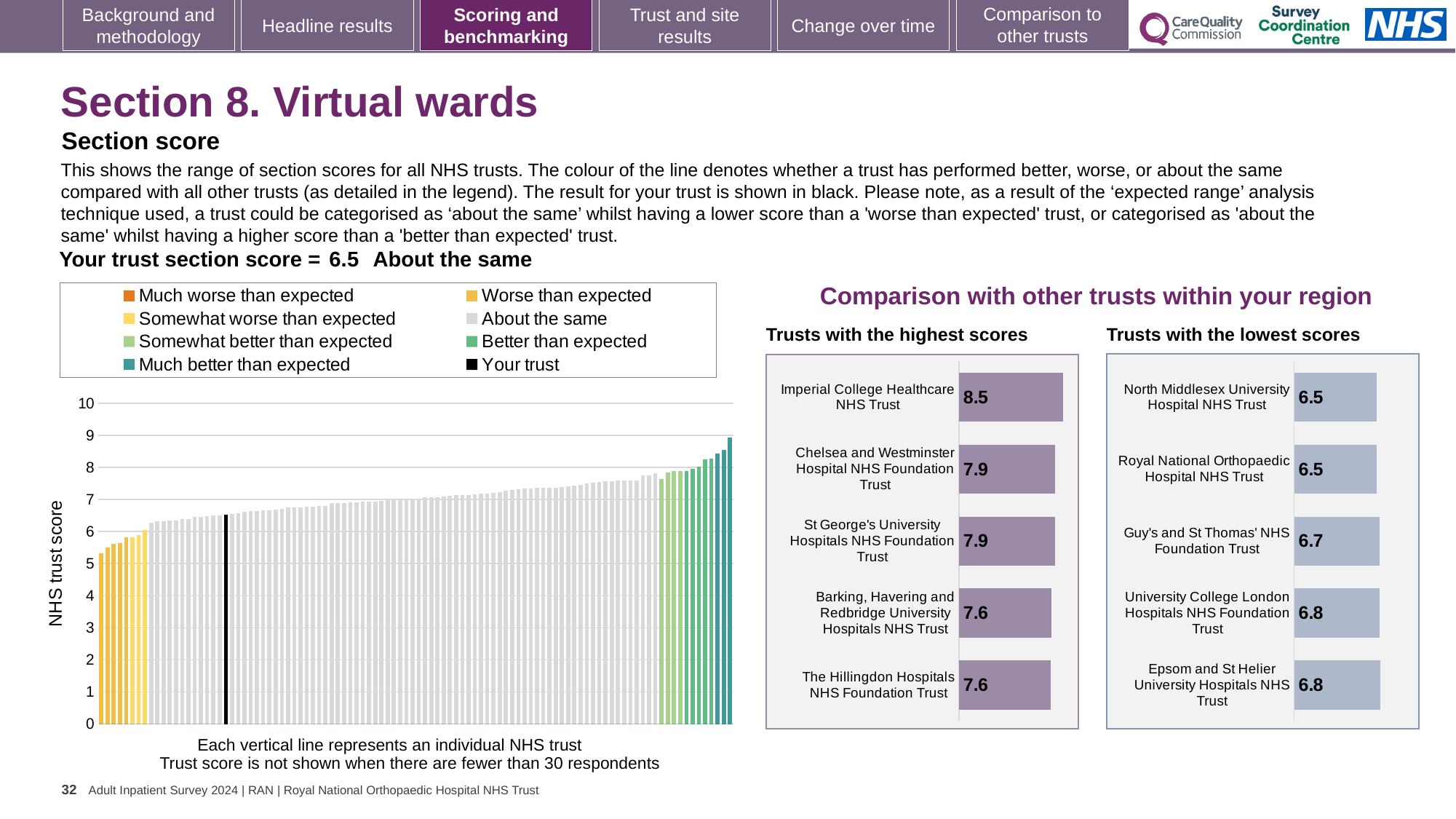
In the NHS trust score chart on the left, is the value of the rightmost (highest) bar greater or less than 8? greater In the 'Trusts with the lowest scores' chart, what is the difference between the scores of Epsom and St Helier University Hospitals NHS Trust and North Middlesex University Hospital NHS Trust? 0.3 In the 'Trusts with the highest scores' chart, which trust has the highest score? Imperial College Healthcare NHS Trust In the 'Trusts with the highest scores' chart, what is the score for Imperial College Healthcare NHS Trust? 8.5 In the 'Trusts with the lowest scores' chart, which has the larger score: Guy's and St Thomas' NHS Foundation Trust or University College London Hospitals NHS Foundation Trust? University College London Hospitals NHS Foundation Trust In the 'Trusts with the highest scores' chart, what is the difference between the scores of Imperial College Healthcare NHS Trust and The Hillingdon Hospitals NHS Foundation Trust? 0.9 How many trusts are shown in the 'Trusts with the lowest scores' chart? 5 In the 'Trusts with the lowest scores' chart, what is the score for Guy's and St Thomas' NHS Foundation Trust? 6.7 In the 'Trusts with the highest scores' chart, what is the score for Barking, Havering and Redbridge University Hospitals NHS Trust? 7.6 In the NHS trust score chart on the left, do the values rise or fall from left to right? rise How many entries does the legend of the NHS trust score chart on the left list? 8 What is the section score for your trust shown in the NHS trust score chart? 6.5